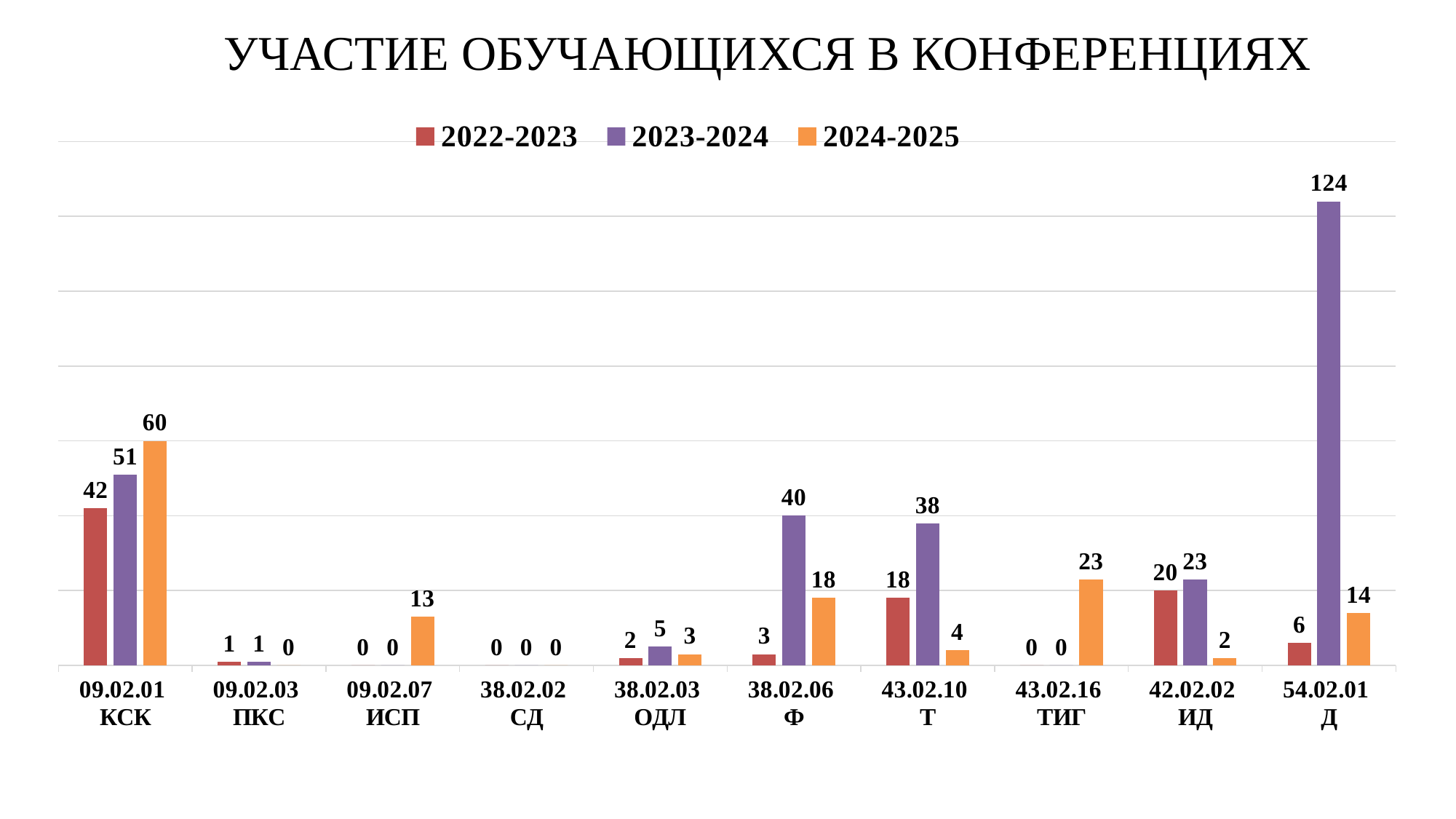
How many categories are shown on the x axis? 10 Which is larger for 38.02.06 Ф: the 2023-2024 value or the 2024-2025 value? 2023-2024 What is the difference between the 2024-2025 and 2022-2023 values for 09.02.01 КСК? 18 Which category has the highest value in the 2023-2024 series? 54.02.01 Д What is the difference between the 2023-2024 and 2024-2025 values for 54.02.01 Д? 110 What is the value for 43.02.10 Т in the 2022-2023 series? 18 What is the value for 09.02.01 КСК in the 2024-2025 series? 60 What is the value for 54.02.01 Д in the 2023-2024 series? 124 What is the title of the chart? УЧАСТИЕ ОБУЧАЮЩИХСЯ В КОНФЕРЕНЦИЯХ What kind of chart is shown on the slide? bar chart Which category has the highest value in the 2022-2023 series? 09.02.01 КСК How many series does the legend list? 3